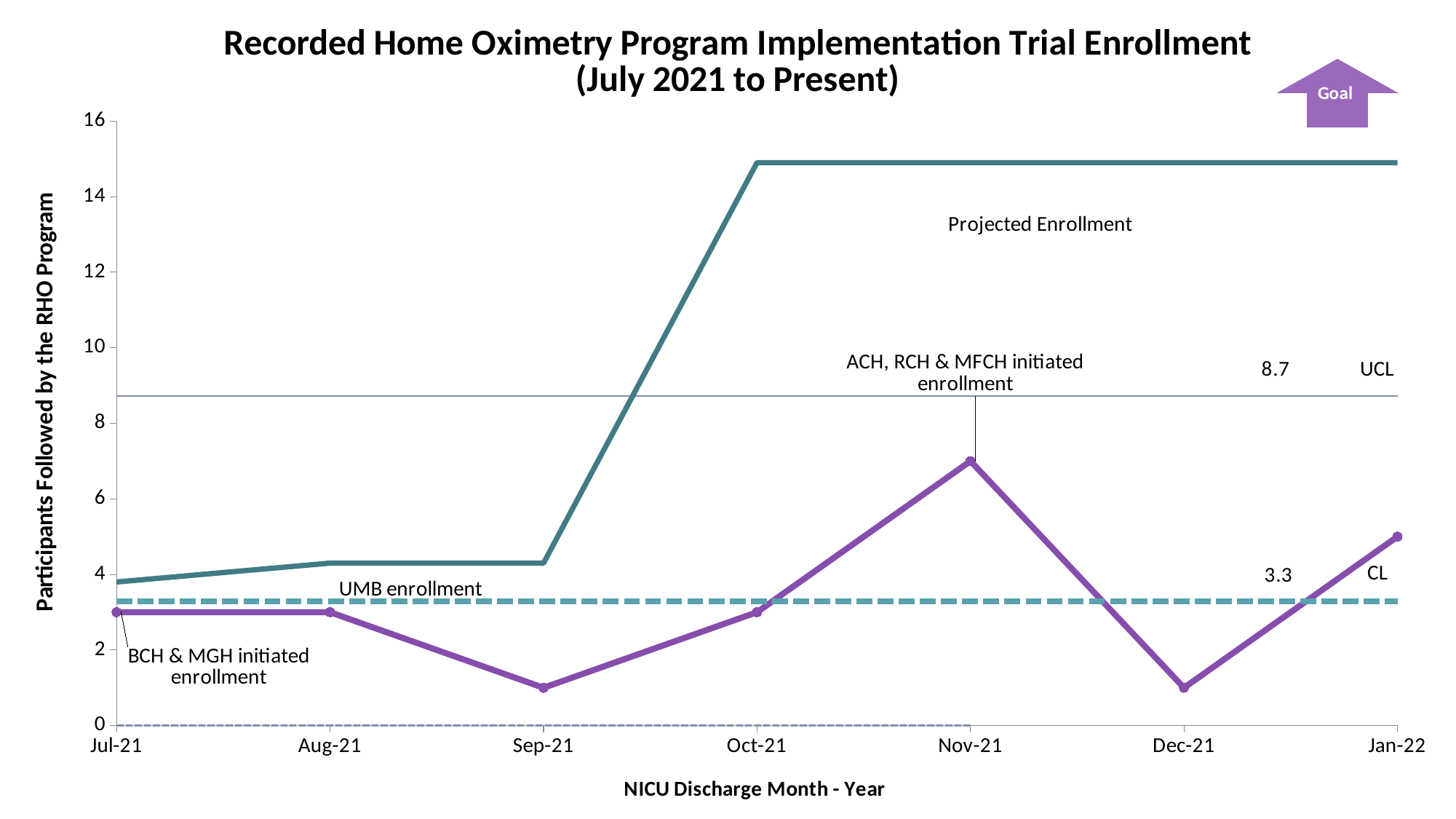
Is the recorded enrollment value for Sep-21 greater or less than 2? less What kind of chart is shown on the slide? line chart Which month has the larger recorded enrollment, Nov-21 or Dec-21? Nov-21 Is the recorded enrollment value for Nov-21 greater or less than 6? greater What is the value of the CL line? 3.3 Does the recorded enrollment line rise or fall from Dec-21 to Jan-22? rise What is the value of the UCL line? 8.7 What is the label of the x axis? NICU Discharge Month - Year How many months are plotted along the x axis? 7 In which month does the recorded enrollment line reach its highest value? Nov-21 Is the recorded enrollment value for Jan-22 greater or less than 4? greater